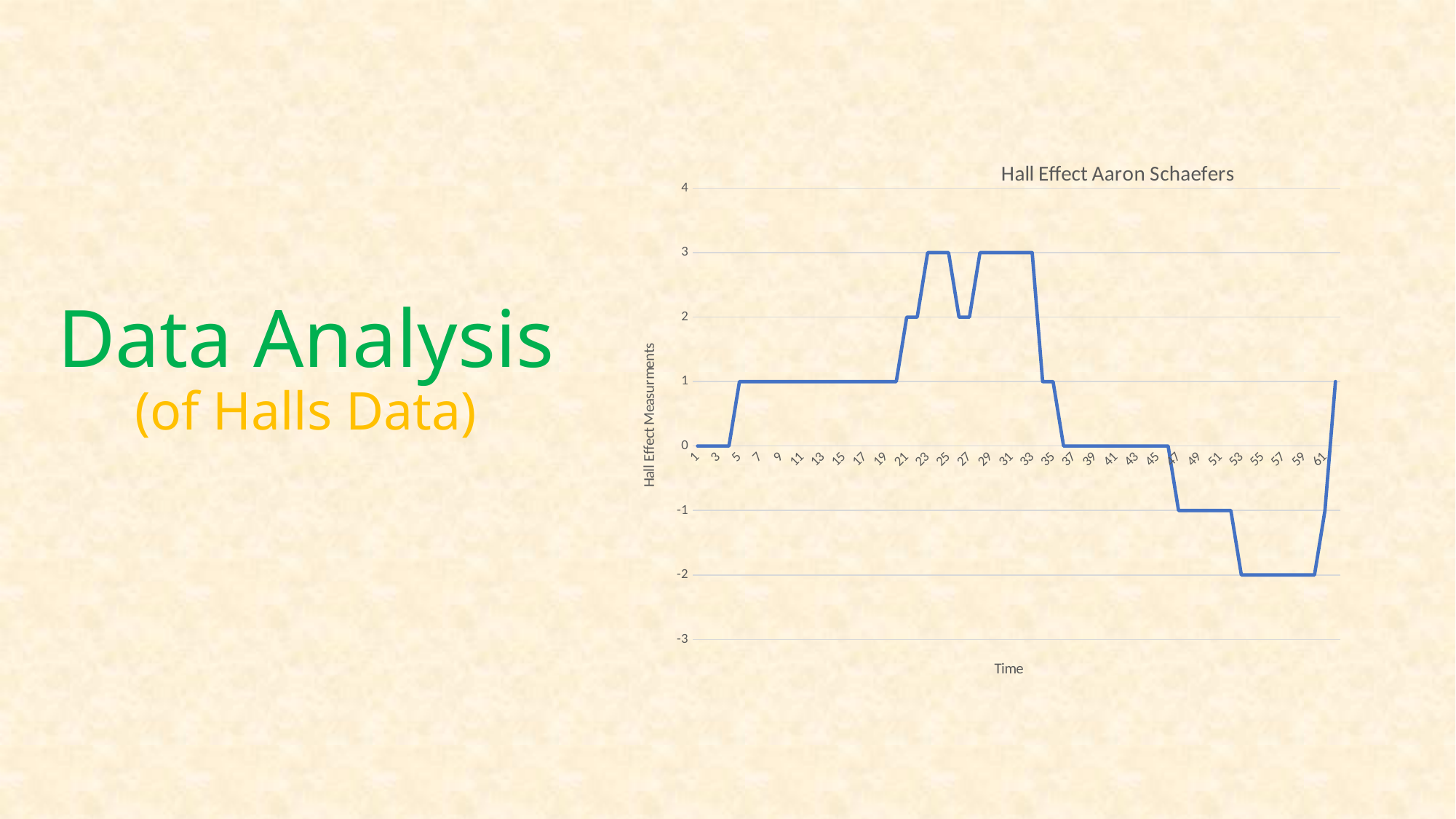
What is the Hall Effect measurement at time 55? -2 What is the Hall Effect measurement at time 31? 3 What is the label on the vertical axis of the chart? Hall Effect Measurments Which is larger, the measurement at time 31 or the measurement at time 49? time 31 What is the difference between the measurement at time 31 and the measurement at time 55? 5 What kind of chart is shown on the slide? line chart What is the title of the chart? Hall Effect Aaron Schaefers What is the Hall Effect measurement at time 11? 1 What is the lowest value reached by the line in the chart? -2 Is the value at time 49 greater or less than 0? less What is the Hall Effect measurement at time 41? 0 What is the highest value reached by the line in the chart? 3